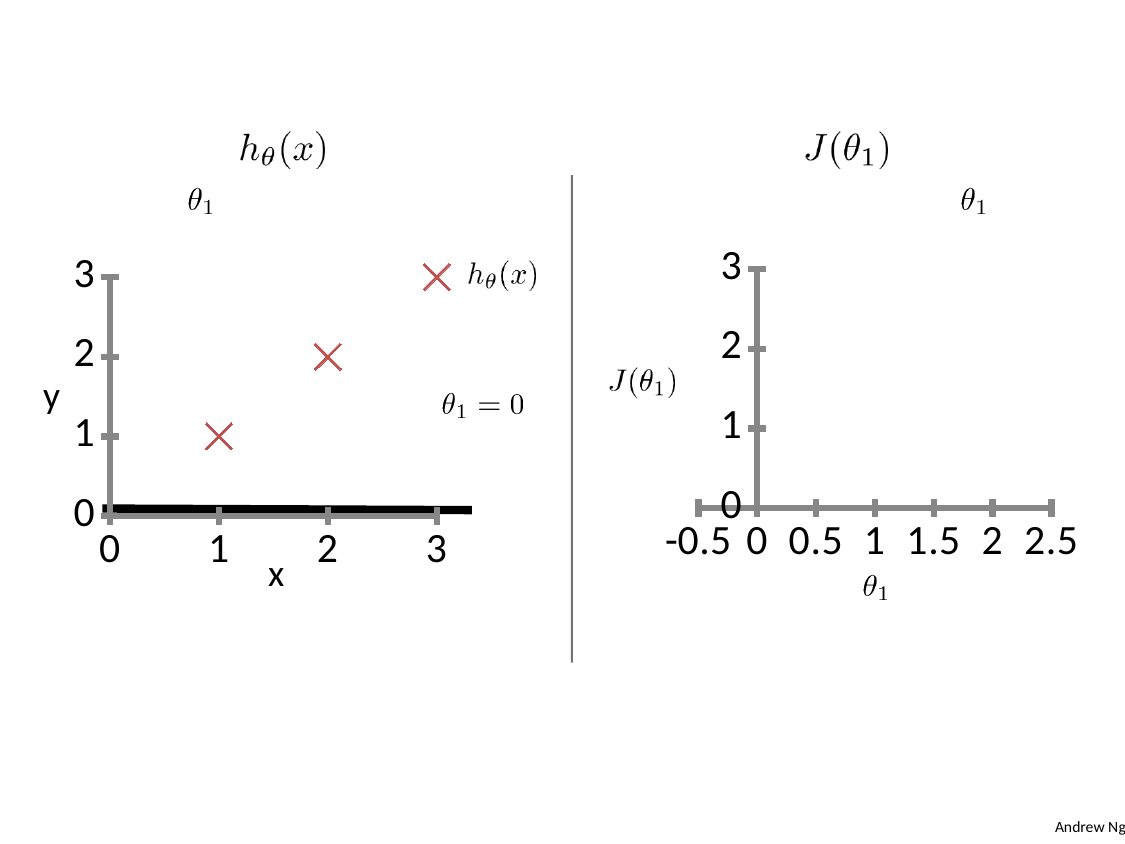
On the left chart titled h_θ(x), what is the y value of the data point at x = 2? 2 On the left chart titled h_θ(x), what is the y value of the data point at x = 3? 3 What kind of chart is the left chart titled h_θ(x)? scatter plot On the left chart titled h_θ(x), which x value has the highest y value among the plotted points? 3 On the left chart titled h_θ(x), what is the difference between the y values at x = 3 and x = 1? 2 On the right chart titled J(θ1), what is the smallest value labelled on the horizontal θ1 axis? -0.5 On the left chart titled h_θ(x), what value of θ1 is stated for the black horizontal line? θ1 = 0 On the left chart titled h_θ(x), how many red X data points are plotted? 3 On the left chart titled h_θ(x), do the y values of the plotted points rise or fall as x increases? rise On the left chart titled h_θ(x), which x value has the lowest y value among the plotted points? 1 On the left chart titled h_θ(x), is the y value at x = 2 larger or smaller than the y value at x = 1? larger On the left chart titled h_θ(x), what is the y value of the data point at x = 1? 1